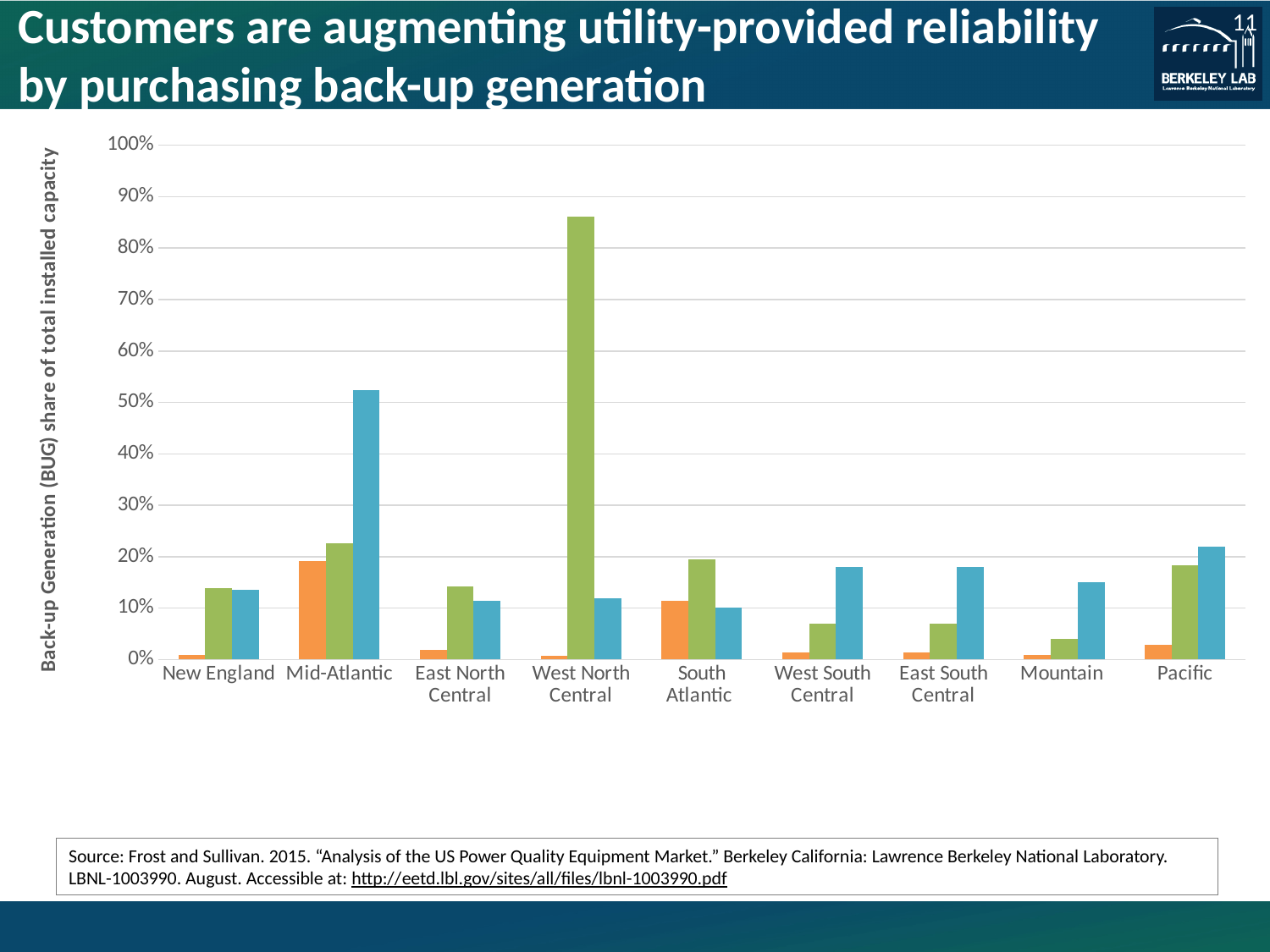
Which region has the tallest orange bar? Mid-Atlantic Which is larger, the blue bar for Mid-Atlantic or the blue bar for Pacific? Mid-Atlantic Is the blue bar for Mid-Atlantic greater or less than 40%? greater Which is larger, the orange bar for South Atlantic or the orange bar for West South Central? South Atlantic What is the label on the vertical axis of the chart? Back-up Generation (BUG) share of total installed capacity Is the blue bar for Mountain greater or less than 20%? less Which region has the tallest bar in the chart? West North Central Is the orange bar for New England greater or less than 10%? less How many regions are shown along the x axis of the chart? 9 What kind of chart is shown on the slide? bar chart